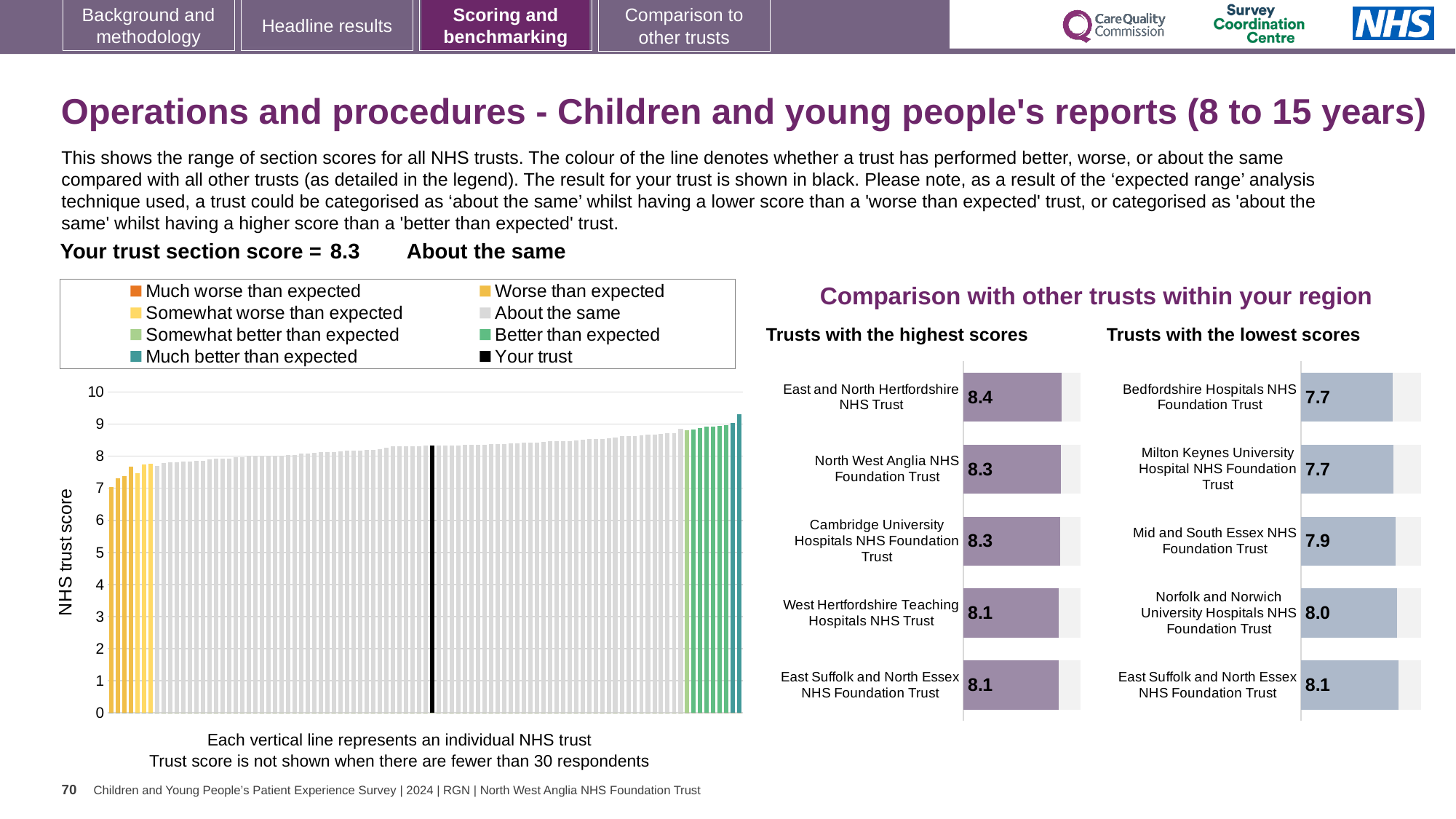
In the 'Trusts with the lowest scores' chart, what is the score for Mid and South Essex NHS Foundation Trust? 7.9 In the large chart on the left, do the bar values rise or fall from left to right? rise In the 'Trusts with the highest scores' chart, which trust has the highest score? East and North Hertfordshire NHS Trust In the large chart on the left, how many entries does the legend list? 8 In the 'Trusts with the highest scores' chart, what is the difference between the scores of East and North Hertfordshire NHS Trust and West Hertfordshire Teaching Hospitals NHS Trust? 0.3 In the large chart on the left, is the value of the black 'Your trust' bar greater or less than 8? greater In the 'Trusts with the lowest scores' chart, which trust has the highest score? East Suffolk and North Essex NHS Foundation Trust In the 'Trusts with the highest scores' chart, how many trusts are shown? 5 What kind of chart is the large chart on the left showing NHS trust scores? Bar chart In the large chart on the left, what is the label on the vertical axis? NHS trust score In the 'Trusts with the lowest scores' chart, which has the larger score: Mid and South Essex NHS Foundation Trust or Norfolk and Norwich University Hospitals NHS Foundation Trust? Norfolk and Norwich University Hospitals NHS Foundation Trust In the 'Trusts with the highest scores' chart, what is the score for East and North Hertfordshire NHS Trust? 8.4